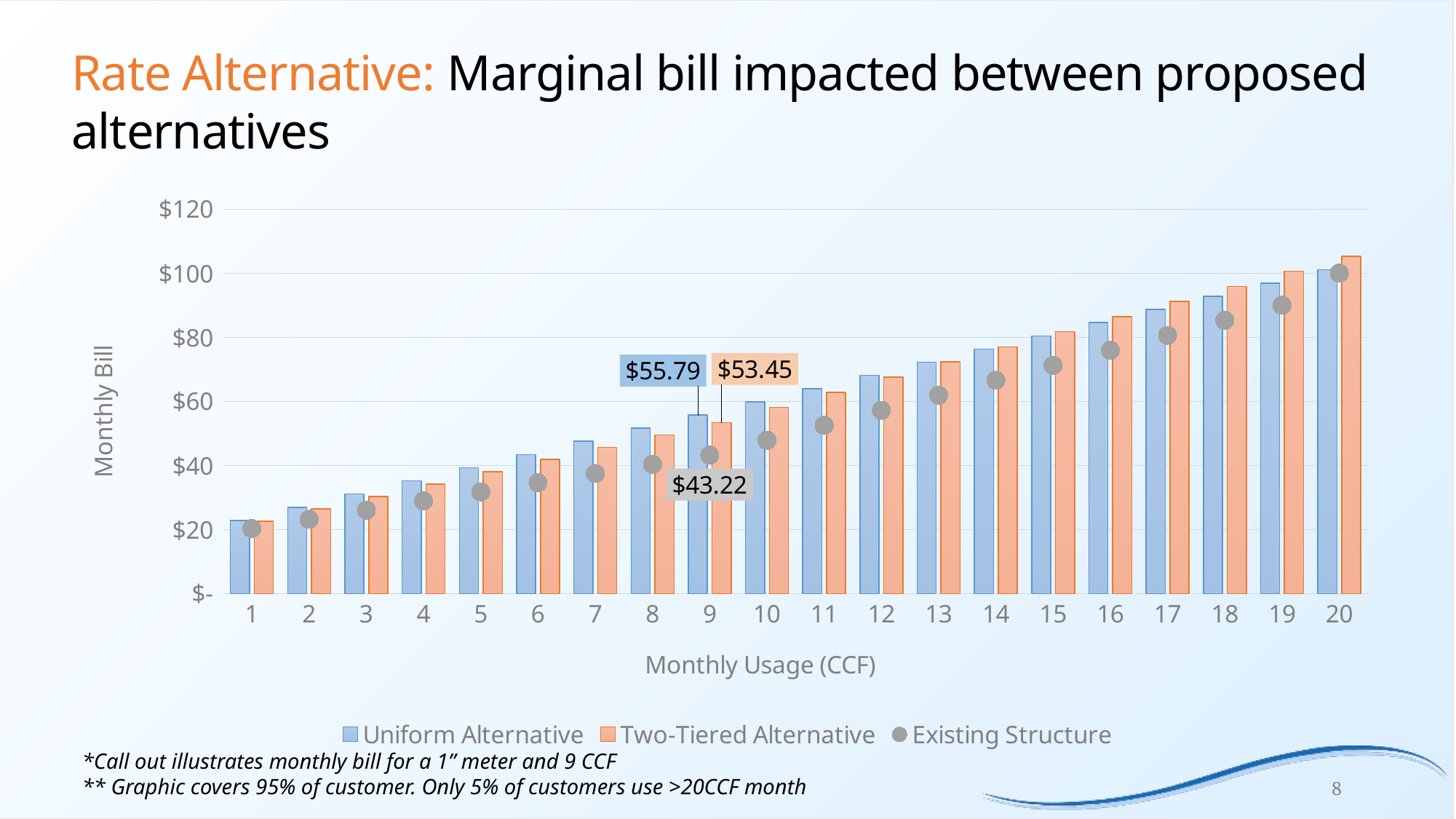
What is the title of the x axis? Monthly Usage (CCF) At 20 CCF, which is larger: the Uniform Alternative bill or the Two-Tiered Alternative bill? Two-Tiered Alternative What is the Existing Structure monthly bill at 9 CCF? $43.22 Is the Two-Tiered Alternative bill at 20 CCF greater or less than $100? greater At 9 CCF, how much higher is the Uniform Alternative bill than the Two-Tiered Alternative bill? $2.34 At 9 CCF, what is the difference between the Uniform Alternative bill and the Existing Structure bill? $12.57 What is the Two-Tiered Alternative monthly bill at 9 CCF? $53.45 Is the Existing Structure bill at 15 CCF greater or less than $60? greater How many series does the legend list? 3 How many monthly usage levels (CCF) are shown on the x axis? 20 Do the monthly bills rise or fall as monthly usage increases? rise What is the Uniform Alternative monthly bill at 9 CCF? $55.79